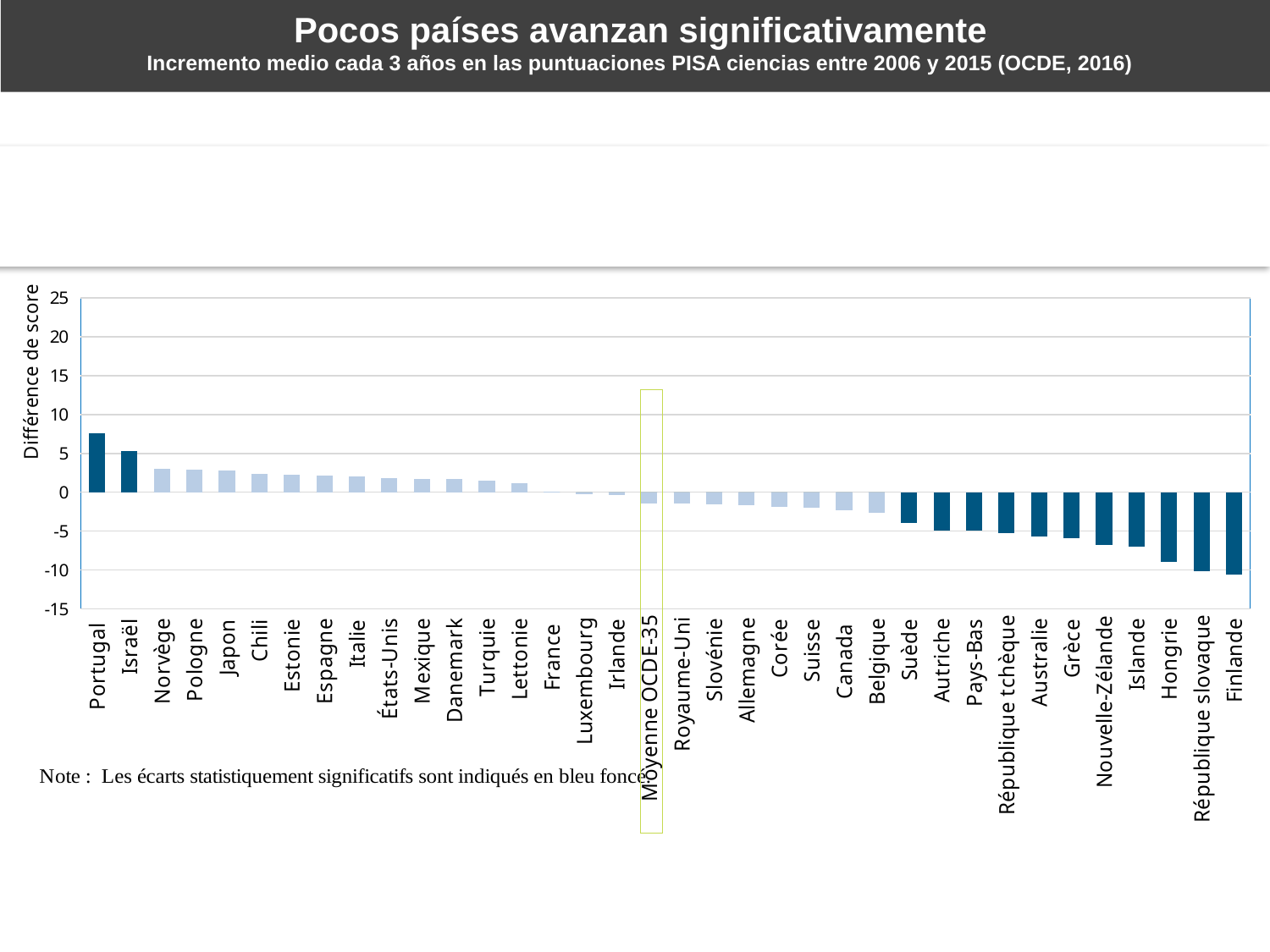
Is the value for Norvège greater or less than 5? less Is the value for Canada greater or less than 0? less Which has the larger value, Islande or Hongrie? Islande Do the values rise or fall moving from left to right along the x axis? Fall Which country has the highest value in the chart? Portugal Which has the larger value, Portugal or Israël? Portugal What is the title of the vertical axis? Différence de score Is the value for Portugal greater or less than 10? less What kind of chart is shown on the slide? Bar chart How many categories (bars) are plotted along the x axis? 36